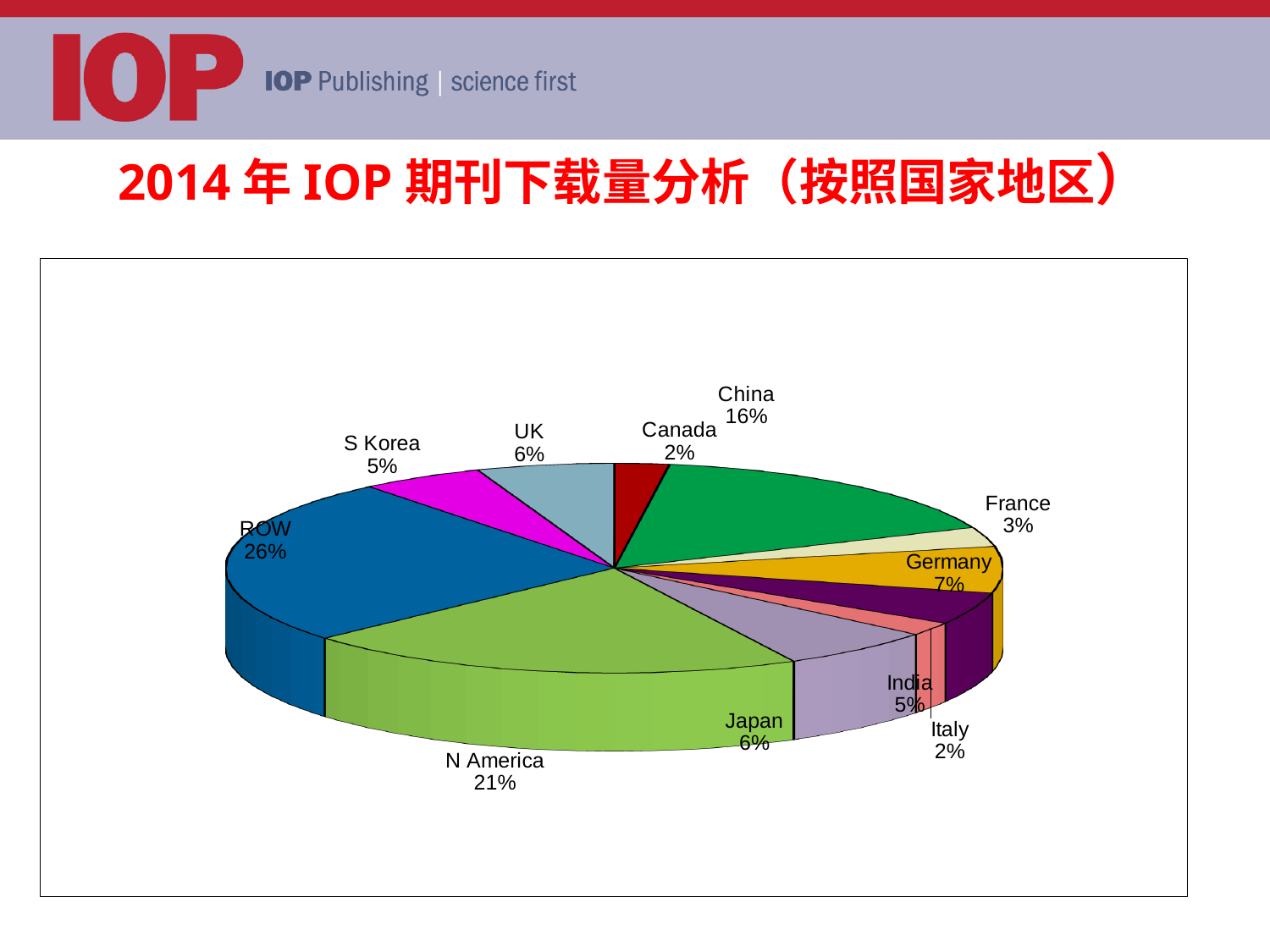
What is the value shown for Germany? 7% Which category has the largest slice of the pie? ROW How many labelled slices does the pie chart have? 11 Which two categories share the smallest value of 2%? Canada and Italy What kind of chart is shown on the slide? Pie chart What is the value shown for N America? 21% What is the value shown for Japan? 6% What is the value shown for ROW? 26% What share of the pie does China account for? 16% Which is larger, the share for UK or the share for S Korea? UK Which is larger, the share for China or the share for Germany? China What is the difference in percentage points between ROW and N America? 5